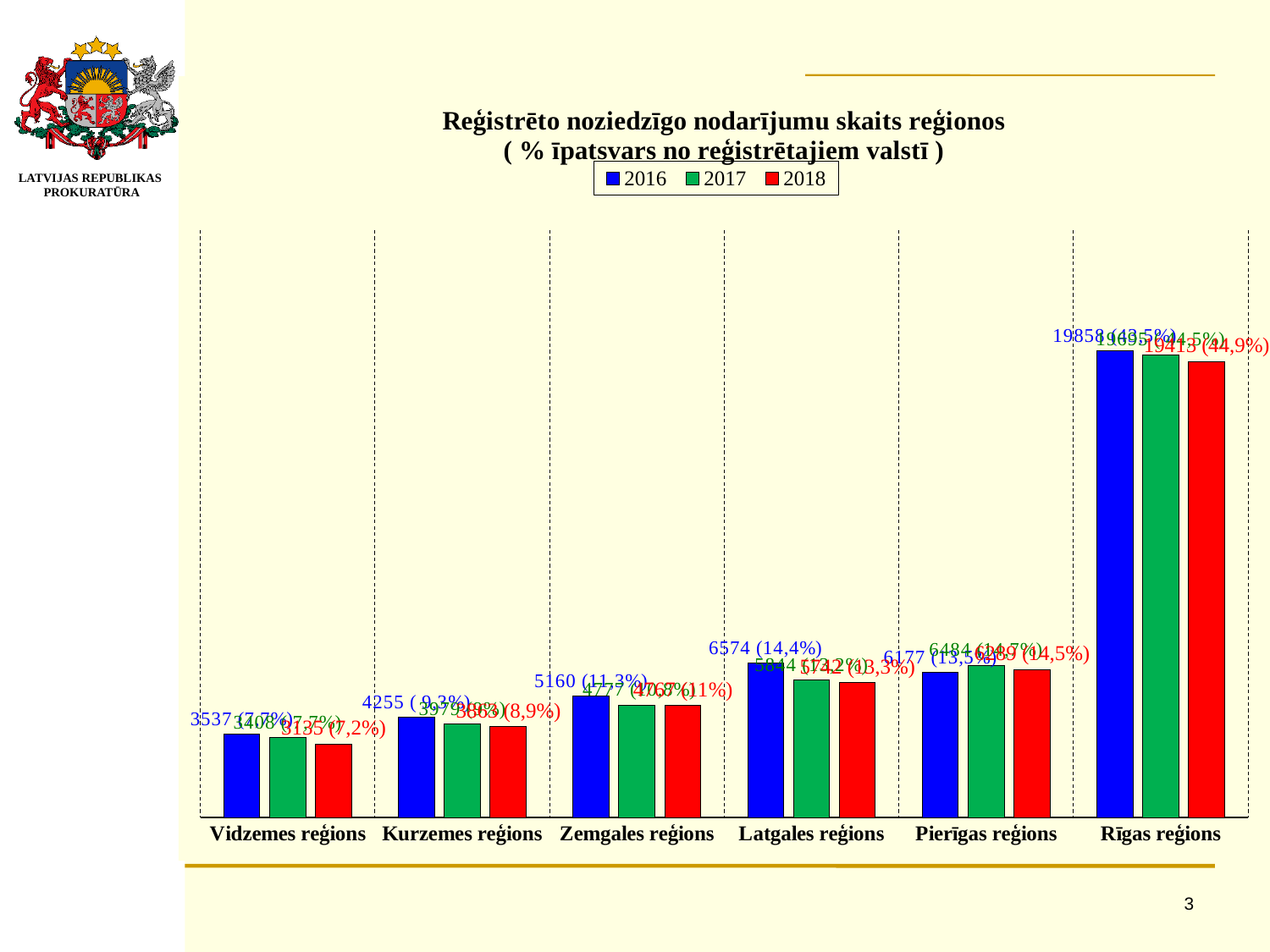
What is the data label for Rīgas reģions in 2018? 19413 (44,9%) How many series does the legend list? 3 Which region has the lowest number of registered criminal offences in 2018? Vidzemes reģions Which years are listed in the chart legend? 2016, 2017, 2018 What is the data label for Latgales reģions in 2016? 6574 (14,4%) Which is larger, the 2016 value for Latgales reģions or the 2016 value for Pierīgas reģions? Latgales reģions By how much did the number of registered offences in Rīgas reģions fall from 2016 to 2018? 445 How many regions are shown on the x axis? 6 Which region has the highest number of registered criminal offences in 2016? Rīgas reģions What is the data label for Rīgas reģions in 2016? 19858 (43,5%) What kind of chart is shown on the slide? bar chart What is the data label for Vidzemes reģions in 2016? 3537 (7,7%)